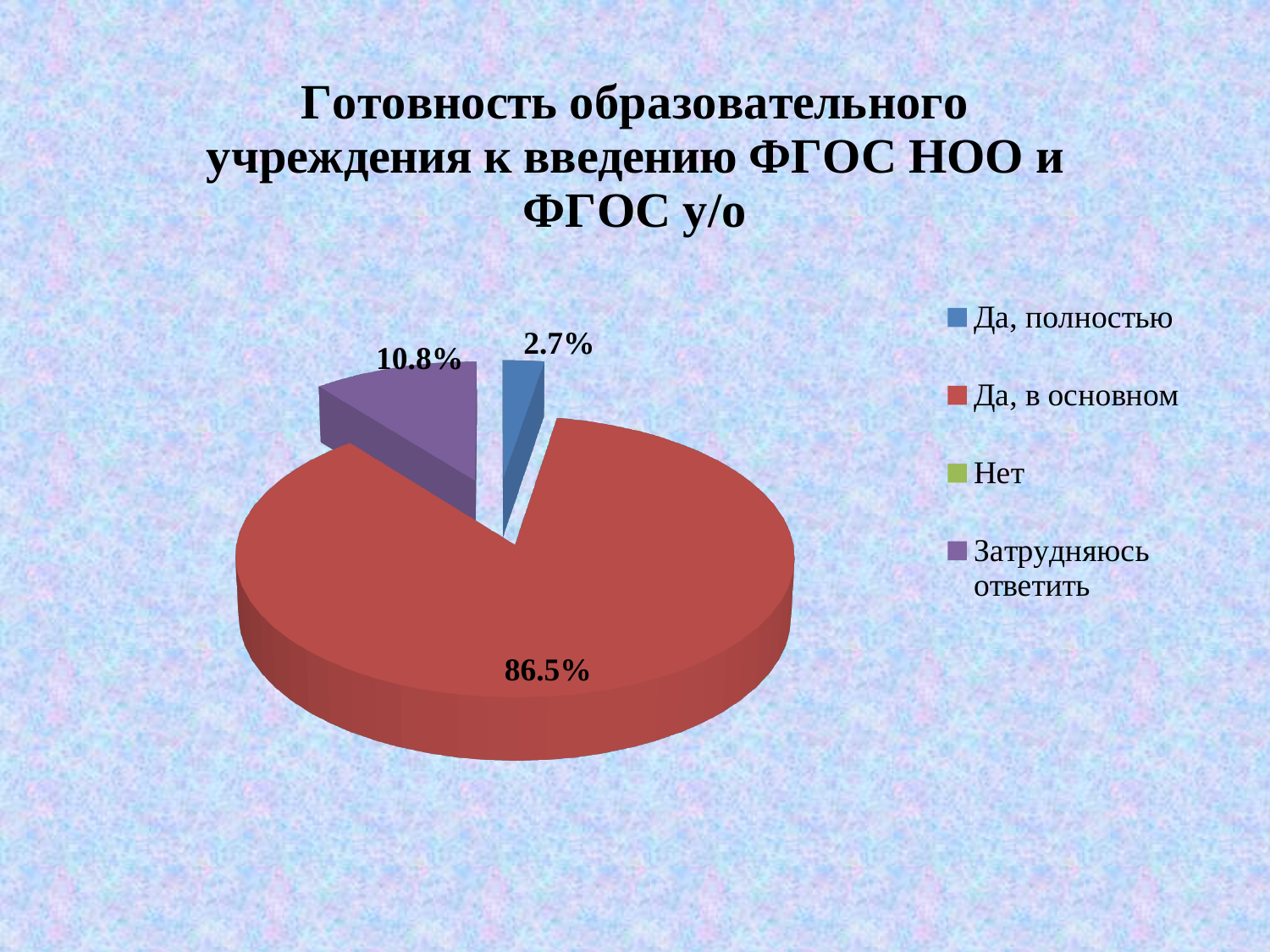
What is the difference in percentage points between "Затрудняюсь ответить" and "Да, полностью"? 8.1 What share of the pie does "Да, полностью" represent? 2.7% How many slices have a percentage label printed on the chart? 3 How many categories does the legend list? 4 What share of the pie does "Да, в основном" represent? 86.5% Which is larger, the slice for "Затрудняюсь ответить" or the slice for "Да, полностью"? Затрудняюсь ответить What share of the pie does "Затрудняюсь ответить" represent? 10.8% What is the difference in percentage points between "Да, в основном" and "Затрудняюсь ответить"? 75.7 What kind of chart is shown on the slide? Pie chart Which of the labeled slices is the smallest? Да, полностью Which category has the largest slice of the pie? Да, в основном What colour represents "Да, в основном" in the chart? Red